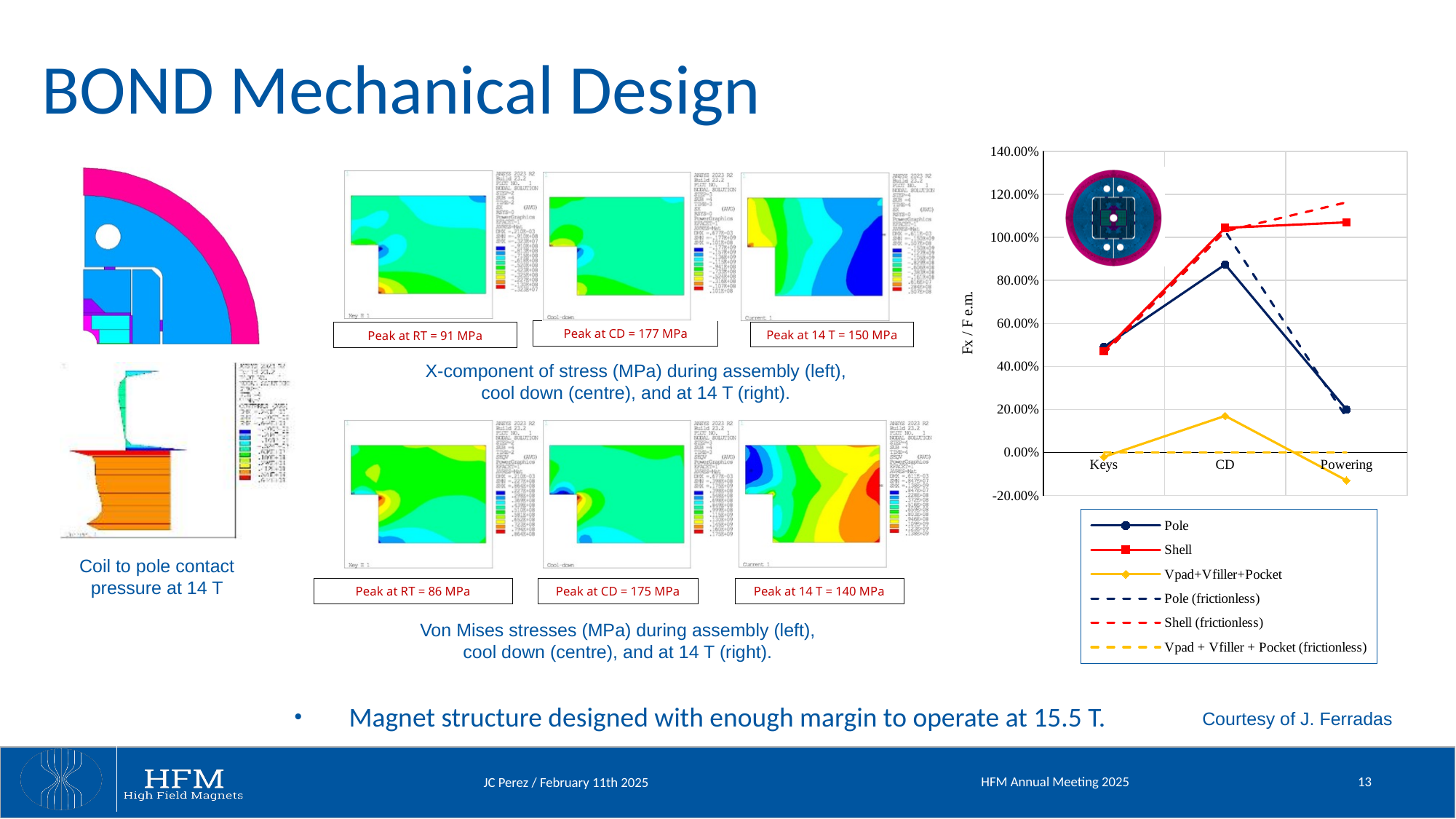
In the line chart, which is larger at Powering: the Shell value or the Pole value? Shell What kind of chart is shown on the right side of the slide? line chart In the line chart, at which category does the Pole series reach its highest value? CD What is the label of the y axis of the line chart? Fx / F e.m. How many categories are shown on the x axis of the line chart? 3 How many series does the legend of the line chart list? 6 In the line chart, is the Pole value at CD greater or less than 80.00%? greater In the line chart, at which category does the Vpad+Vfiller+Pocket series reach its lowest value? Powering In the line chart, does the Pole series rise or fall from CD to Powering? fall In the line chart, is the Shell value at CD greater or less than 100.00%? greater In the line chart, is the Vpad+Vfiller+Pocket value at CD greater or less than 0.00%? greater